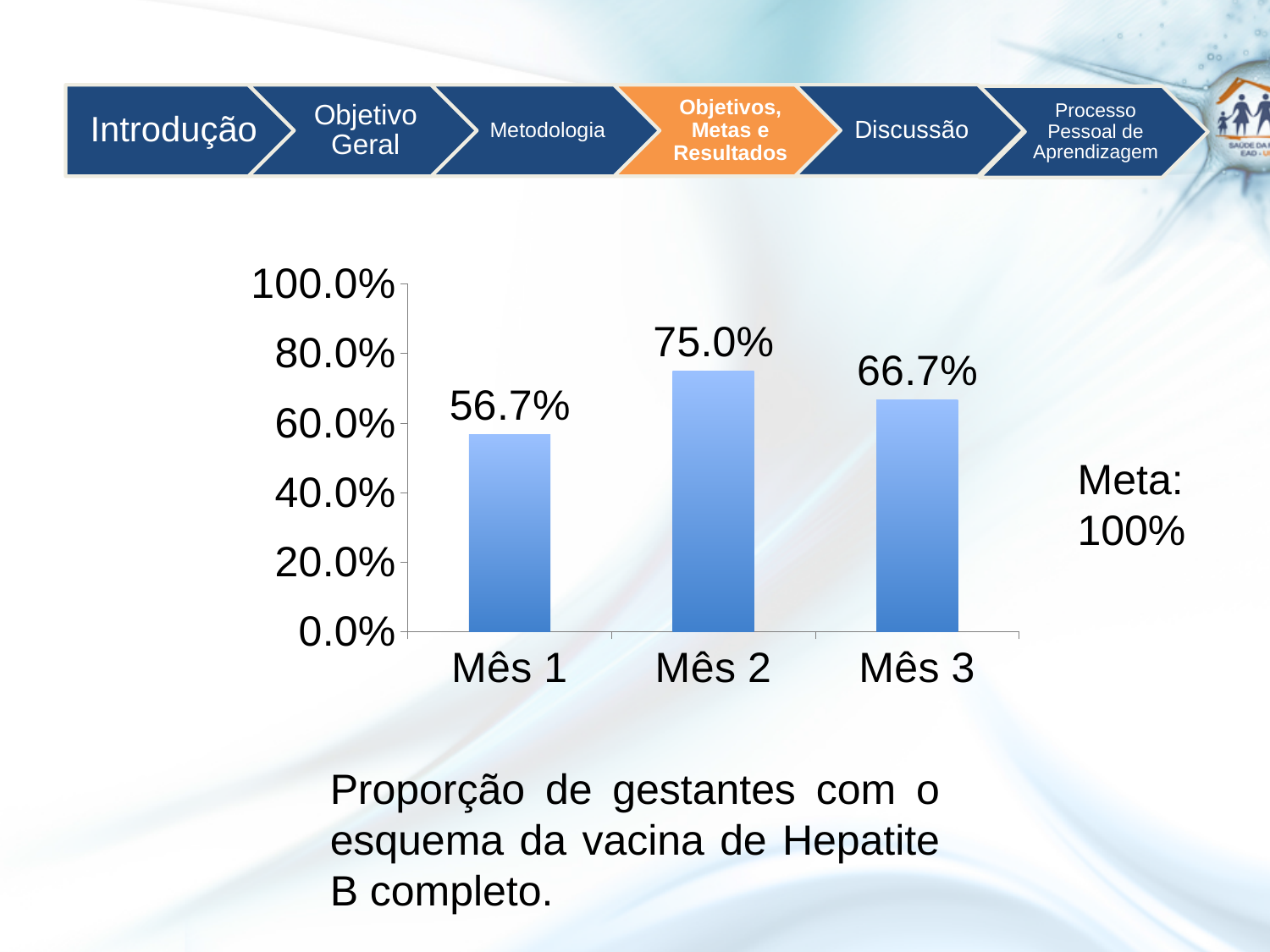
Which is larger, the value for Mês 3 or the value for Mês 1? Mês 3 Is the value for Mês 2 greater or less than 60.0%? greater Which month has the lowest value? Mês 1 What target (Meta) is stated next to the chart? 100% What kind of chart is shown on the slide? Bar chart What is the difference between the values for Mês 2 and Mês 3? 8.3% What is the value for Mês 2? 75.0% What is the difference between the values for Mês 2 and Mês 1? 18.3% What is the value for Mês 1? 56.7% Which month has the highest value? Mês 2 How many months are shown on the x axis? 3 What is the value for Mês 3? 66.7%